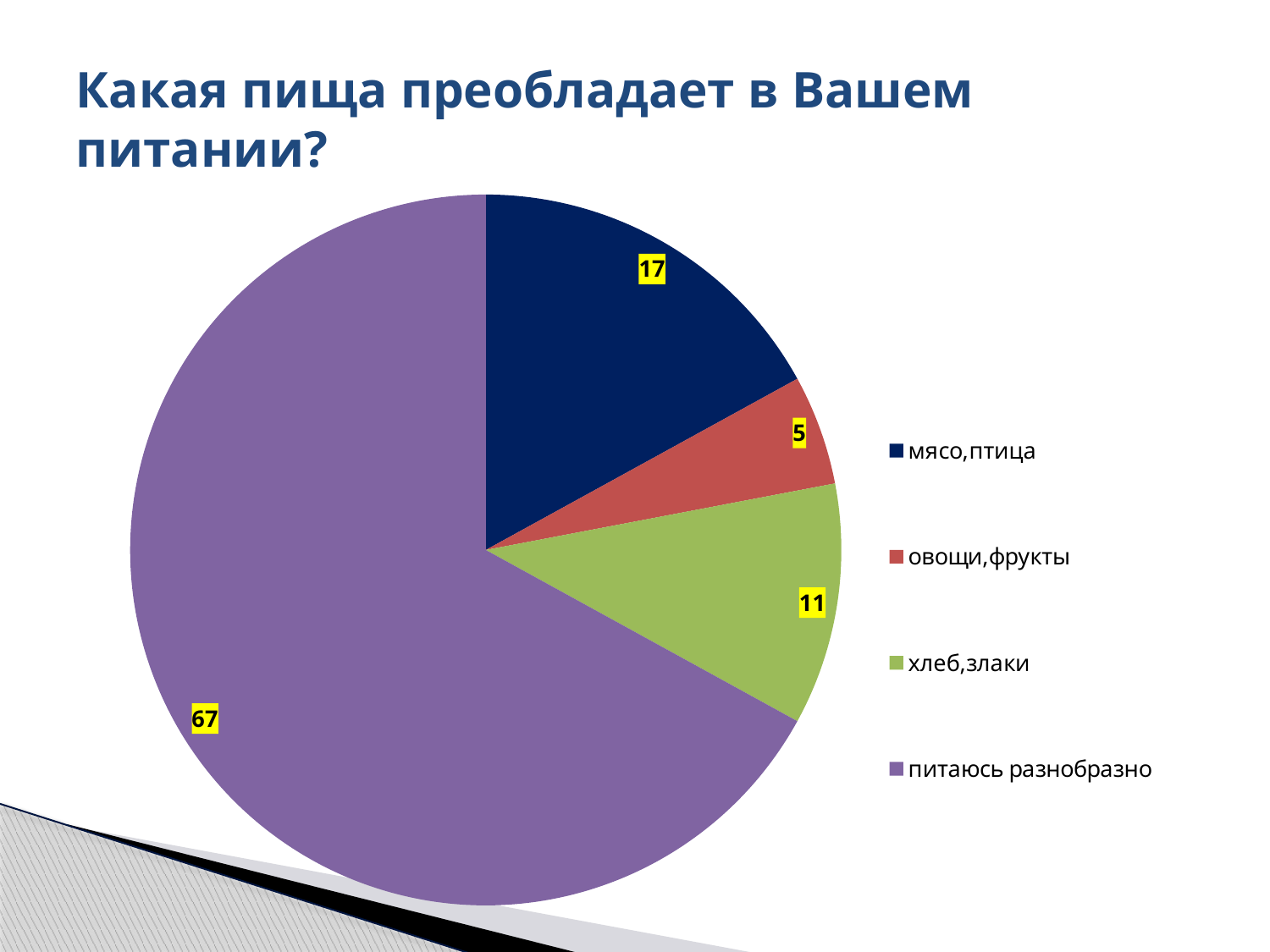
What share of the pie does the питаюсь разнообразно slice represent? 67% Which category has the smallest slice? овощи,фрукты What is the value for хлеб,злаки? 11 How many categories does the pie chart have? 4 Which is larger, the value for хлеб,злаки or the value for овощи,фрукты? хлеб,злаки What is the value for питаюсь разнообразно? 67 What is the title of the slide? Какая пища преобладает в Вашем питании? Which category has the largest slice? питаюсь разнобразно What is the value for мясо,птица? 17 What kind of chart is shown on the slide? pie chart What is the value for овощи,фрукты? 5 What is the difference between the values for мясо,птица and хлеб,злаки? 6